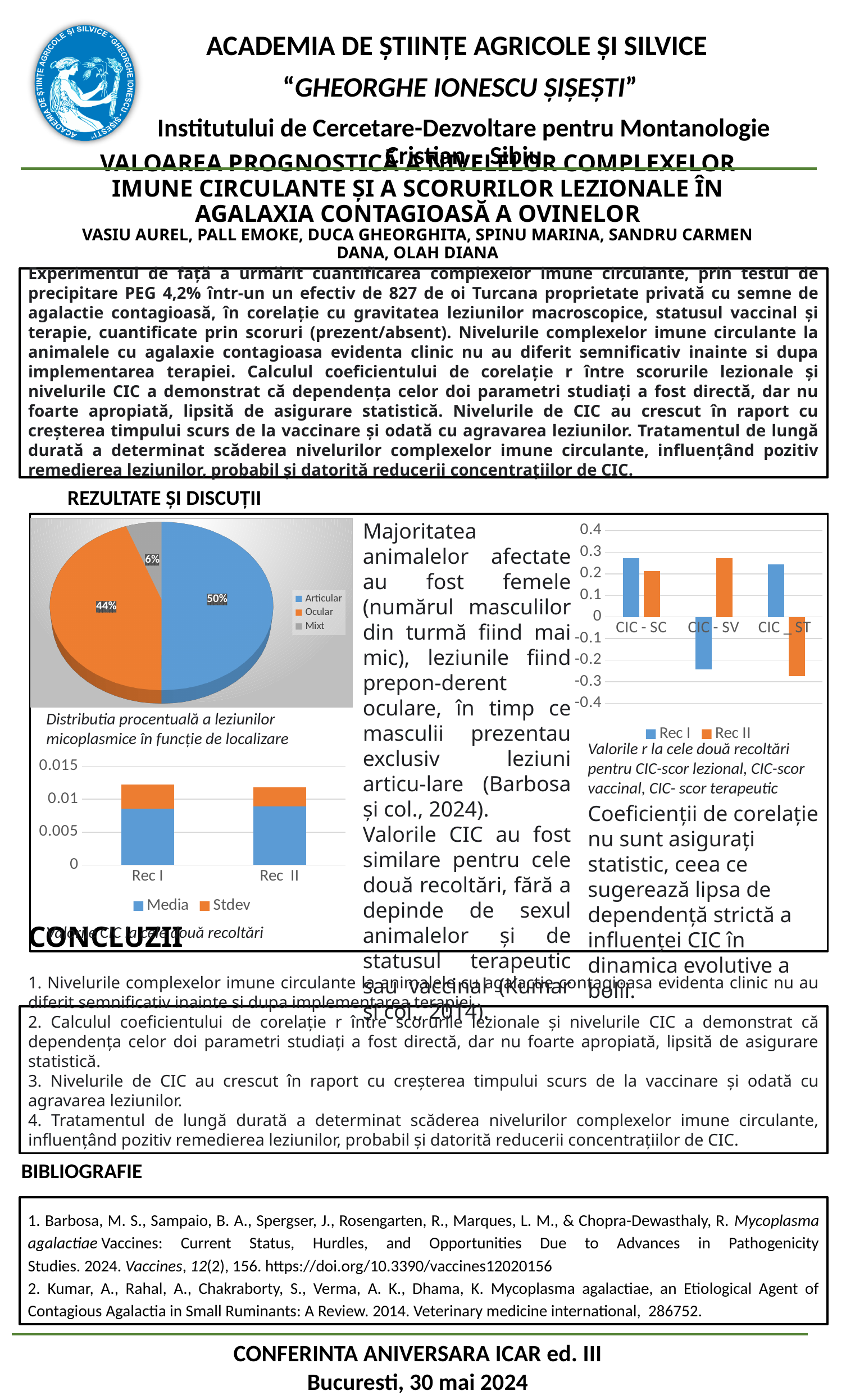
In the pie chart 'Distributia procentuală a leziunilor micoplasmice în funcție de localizare', what percentage is shown for Articular? 50% In the chart 'Valorile CIC la cele două recoltări', is the Media value for Rec I greater or less than 0.01? less In the chart 'Valorile r la cele două recoltări', how many categories are shown on the x axis? 3 In the pie chart 'Distributia procentuală a leziunilor micoplasmice în funcție de localizare', which category has the smallest share? Mixt In the pie chart 'Distributia procentuală a leziunilor micoplasmice în funcție de localizare', what is the difference in percentage points between Articular and Ocular? 6% What kind of chart is 'Valorile CIC la cele două recoltări'? Stacked bar chart In the chart 'Valorile CIC la cele două recoltări', how many series does the legend list? 2 In the pie chart 'Distributia procentuală a leziunilor micoplasmice în funcție de localizare', which category has the largest share? Articular In the chart 'Valorile r la cele două recoltări', is the Rec I value for CIC - SV greater or less than 0? less In the chart 'Valorile r la cele două recoltări', which category has the lowest Rec II value? CIC _ ST In the pie chart 'Distributia procentuală a leziunilor micoplasmice în funcție de localizare', how many categories are shown? 3 In the pie chart 'Distributia procentuală a leziunilor micoplasmice în funcție de localizare', what percentage is shown for Mixt? 6%